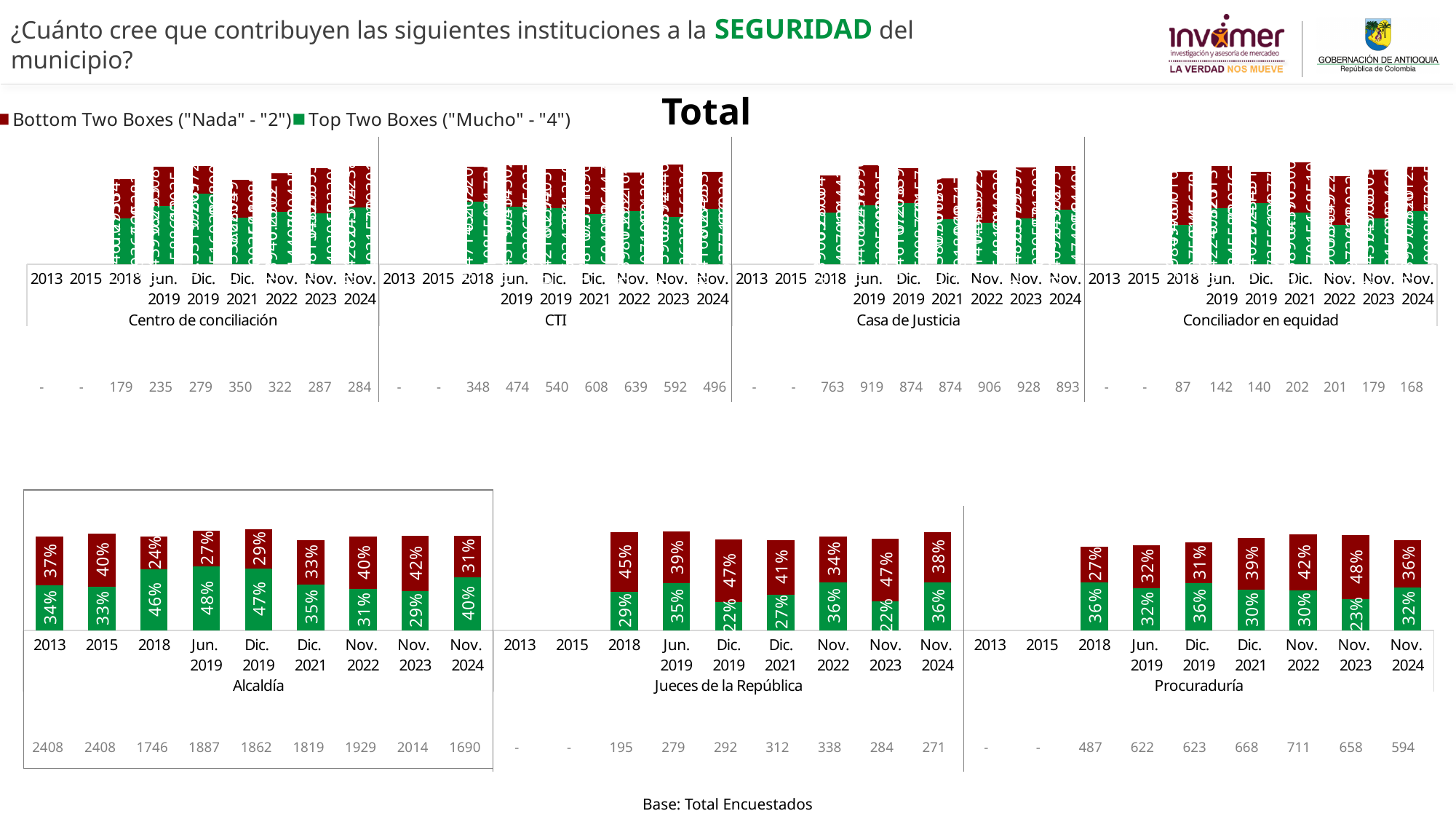
How many periods have plotted bars in the Alcaldía chart? 9 How many series does the legend list? 2 In the Procuraduría chart, which is larger for Nov. 2024: the Bottom Two Boxes value or the Top Two Boxes value? Bottom Two Boxes (36%) In the Jueces de la República chart, what is the difference between the Bottom Two Boxes and Top Two Boxes values for 2018? 16% In the Procuraduría chart, what is the Bottom Two Boxes ("Nada" - "2") value for Nov. 2023? 48% In the Alcaldía chart, which period has the highest Top Two Boxes ("Mucho" - "4") value? Jun. 2019 In the Alcaldía chart, what is the Bottom Two Boxes ("Nada" - "2") value for Nov. 2023? 42% In the Procuraduría chart, which period has the lowest Top Two Boxes ("Mucho" - "4") value? Nov. 2023 In the Alcaldía chart, what is the combined total of the Bottom Two Boxes and Top Two Boxes values for Dic. 2021? 68% In the Alcaldía chart, what is the Top Two Boxes ("Mucho" - "4") value for Nov. 2024? 40% What kind of chart is used for Jueces de la República? Stacked bar chart In the Jueces de la República chart, what is the Top Two Boxes ("Mucho" - "4") value for Nov. 2022? 36%